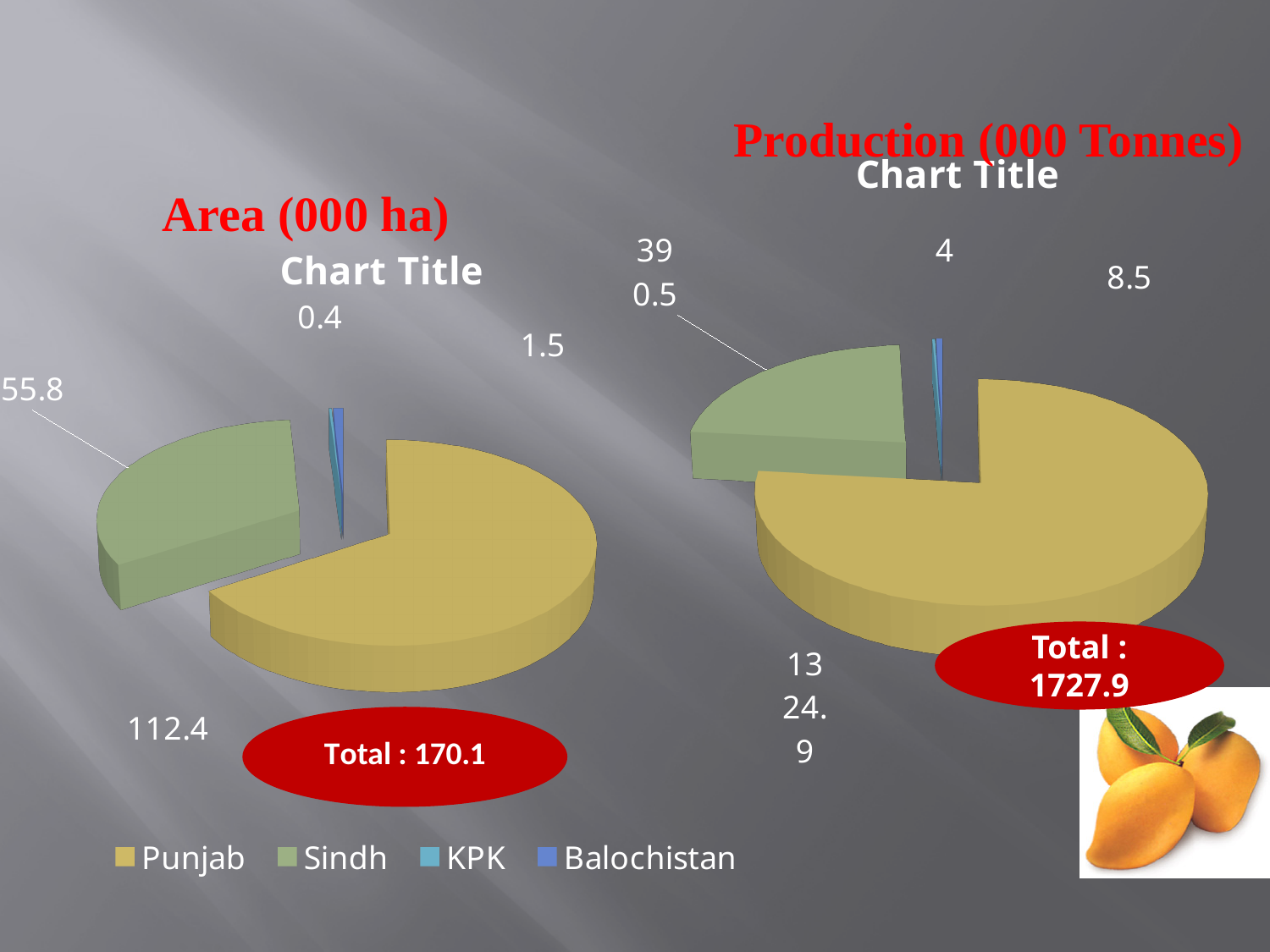
In the Production (000 Tonnes) chart, what is the value for Balochistan? 8.5 In the Area (000 ha) chart, what is the value for KPK? 0.4 In the Area (000 ha) chart, what is the value for Sindh? 55.8 In the Area (000 ha) chart, what is the value for Punjab? 112.4 In the Area (000 ha) chart, what is the value for Balochistan? 1.5 How many provinces does the legend list? 4 In the Area (000 ha) chart, which province has the smallest area? KPK In the Area (000 ha) chart, which province has the largest area? Punjab What type of charts are shown on the slide? Pie charts In the Production (000 Tonnes) chart, what is the value for KPK? 4 In the Production (000 Tonnes) chart, which province has the largest production? Punjab In the Area (000 ha) chart, what is the difference between the values for Punjab and Sindh? 56.6